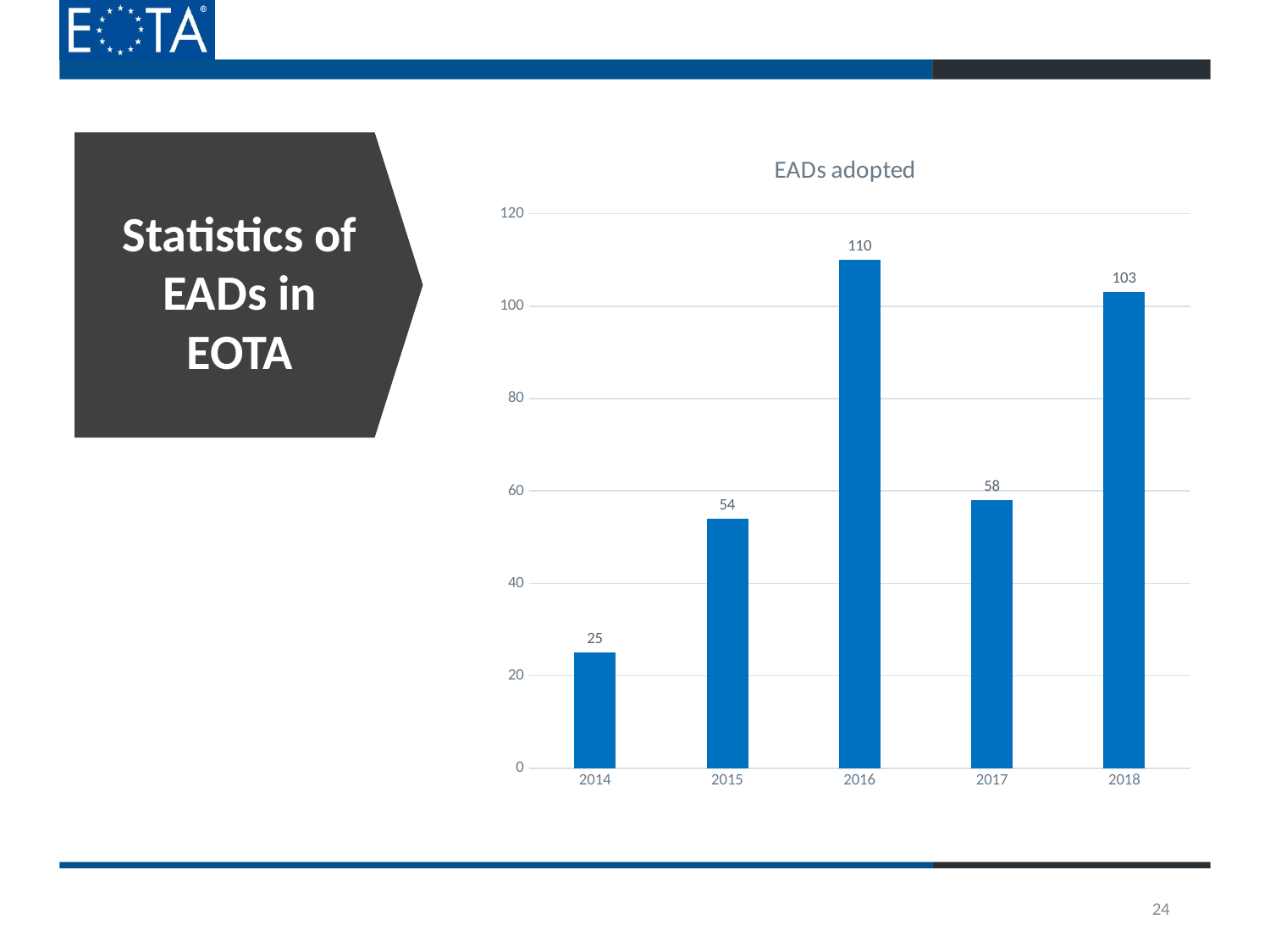
Which year had more EADs adopted, 2015 or 2017? 2017 How many more EADs were adopted in 2015 than in 2014? 29 Which year has the highest number of EADs adopted? 2016 Is the value for 2018 greater or less than 100? greater How many years are shown on the x axis of the chart? 5 What type of chart is used to show EADs adopted? bar chart Which year has the lowest number of EADs adopted? 2014 What is the value shown for 2014 in the EADs adopted chart? 25 What is the title of the chart on the slide? EADs adopted How many EADs were adopted in 2016? 110 How many EADs were adopted in 2018? 103 What is the difference between the EADs adopted in 2016 and in 2017? 52